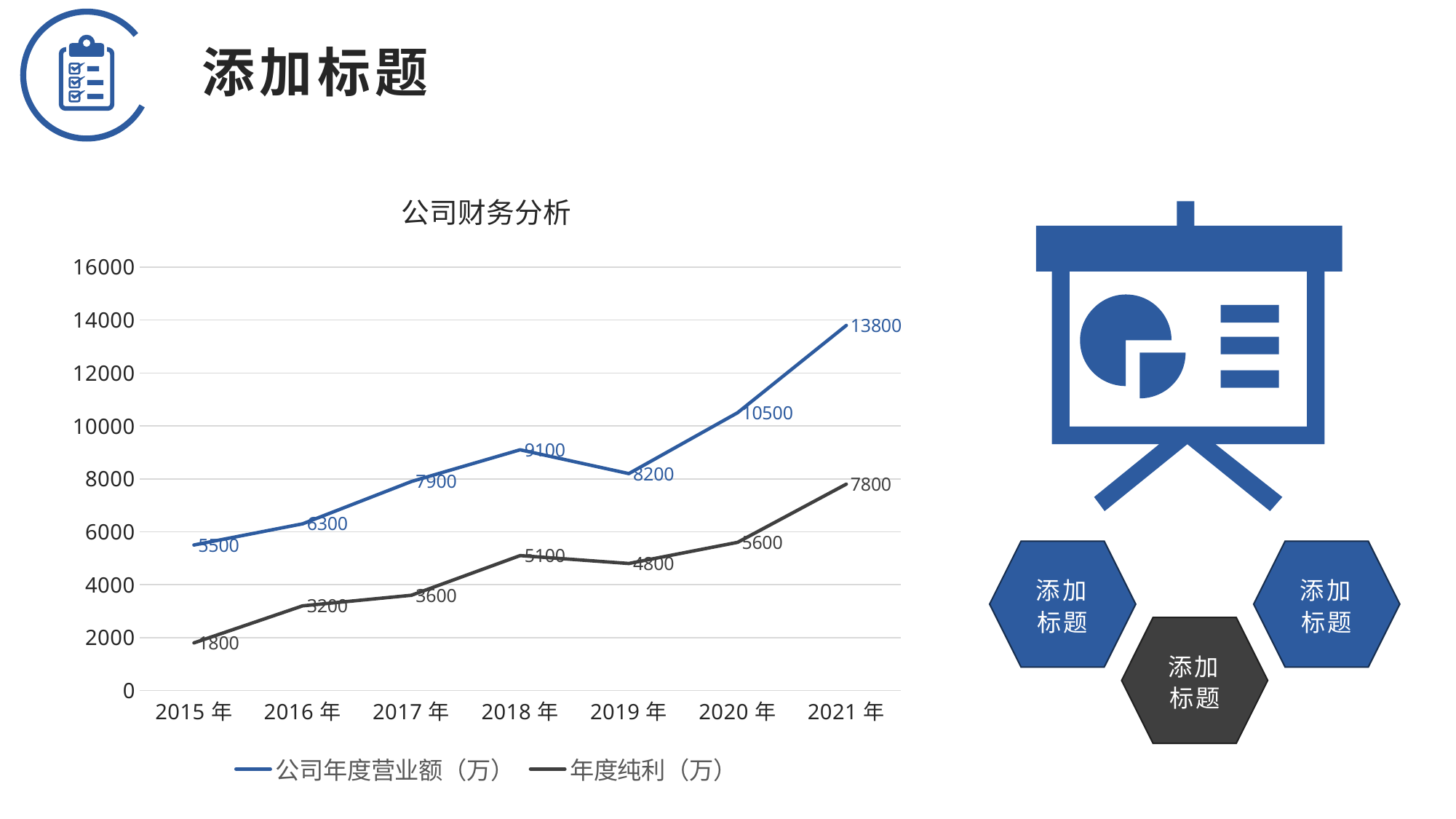
What type of chart is shown under the title 公司财务分析? line chart Does 年度纯利（万） rise or fall from 2018 年 to 2019 年? fall What is the value of 公司年度营业额（万） for 2019 年? 8200 How many years are shown on the x axis? 7 Which year has the lowest value for 年度纯利（万）? 2015 年 What is the value of 年度纯利（万） for 2018 年? 5100 What is the value of 年度纯利（万） for 2015 年? 1800 Which year has the highest value for 公司年度营业额（万）? 2021 年 What is the difference between 公司年度营业额（万） and 年度纯利（万） in 2020 年? 4900 Which is larger: 公司年度营业额（万） in 2018 年 or 公司年度营业额（万） in 2019 年? 2018 年 What is the value of 公司年度营业额（万） for 2021 年? 13800 How many series does the legend list? 2